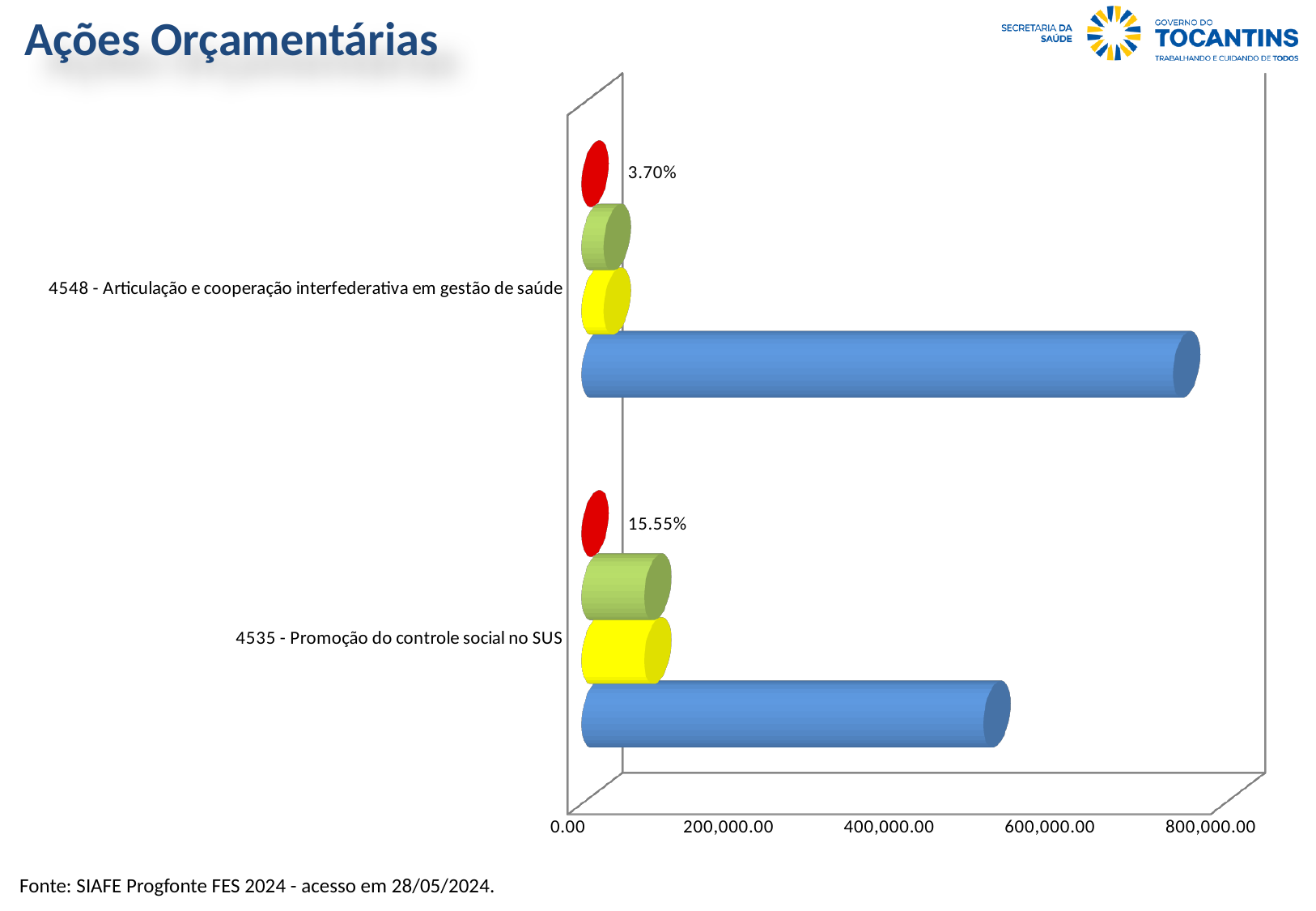
What is the title of the slide containing the chart? Ações Orçamentárias Is the value of the blue bar for "4548 - Articulação e cooperação interfederativa em gestão de saúde" greater or less than 600,000.00? greater What kind of chart is shown on the slide? bar chart What percentage label is shown for "4535 - Promoção do controle social no SUS"? 15.55% What is the difference between the percentage labels of 4535 (15.55%) and 4548 (3.70%)? 11.85% Which category has the higher percentage label, 4548 or 4535? 4535 - Promoção do controle social no SUS Which category has the longer blue bar? 4548 - Articulação e cooperação interfederativa em gestão de saúde Is the value of the blue bar for "4535 - Promoção do controle social no SUS" greater or less than 400,000.00? greater How many categories (budget actions) are shown on the chart? 2 Is the value of the blue bar for "4535 - Promoção do controle social no SUS" greater or less than 600,000.00? less What source is cited below the chart? SIAFE Progfonte FES 2024 - acesso em 28/05/2024 What percentage label is shown for "4548 - Articulação e cooperação interfederativa em gestão de saúde"? 3.70%